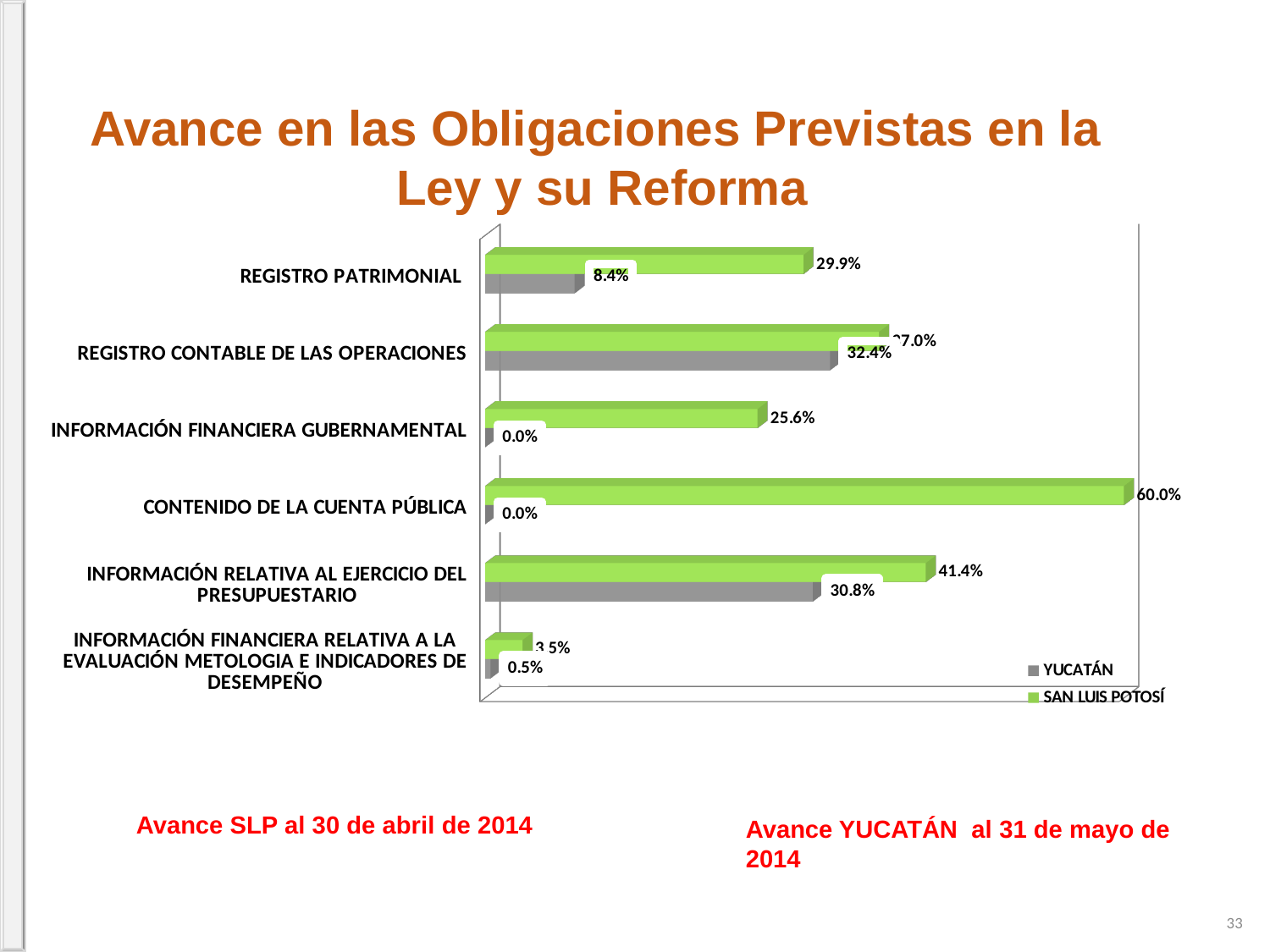
What is the value for SAN LUIS POTOSÍ in the CONTENIDO DE LA CUENTA PÚBLICA category? 60.0% What is the value for SAN LUIS POTOSÍ in the INFORMACIÓN FINANCIERA GUBERNAMENTAL category? 25.6% How many categories are shown on the chart? 6 What is the value for YUCATÁN in the CONTENIDO DE LA CUENTA PÚBLICA category? 0.0% What kind of chart is shown on the slide? bar chart What is the difference between the SAN LUIS POTOSÍ and YUCATÁN values for REGISTRO PATRIMONIAL? 21.5% What is the value for YUCATÁN in the INFORMACIÓN RELATIVA AL EJERCICIO DEL PRESUPUESTARIO category? 30.8% What is the value for SAN LUIS POTOSÍ in the REGISTRO PATRIMONIAL category? 29.9% What is the value for YUCATÁN in the REGISTRO PATRIMONIAL category? 8.4% In the INFORMACIÓN RELATIVA AL EJERCICIO DEL PRESUPUESTARIO category, which series has the larger value, YUCATÁN or SAN LUIS POTOSÍ? SAN LUIS POTOSÍ How many series does the legend list? 2 Which category has the highest value for SAN LUIS POTOSÍ? CONTENIDO DE LA CUENTA PÚBLICA